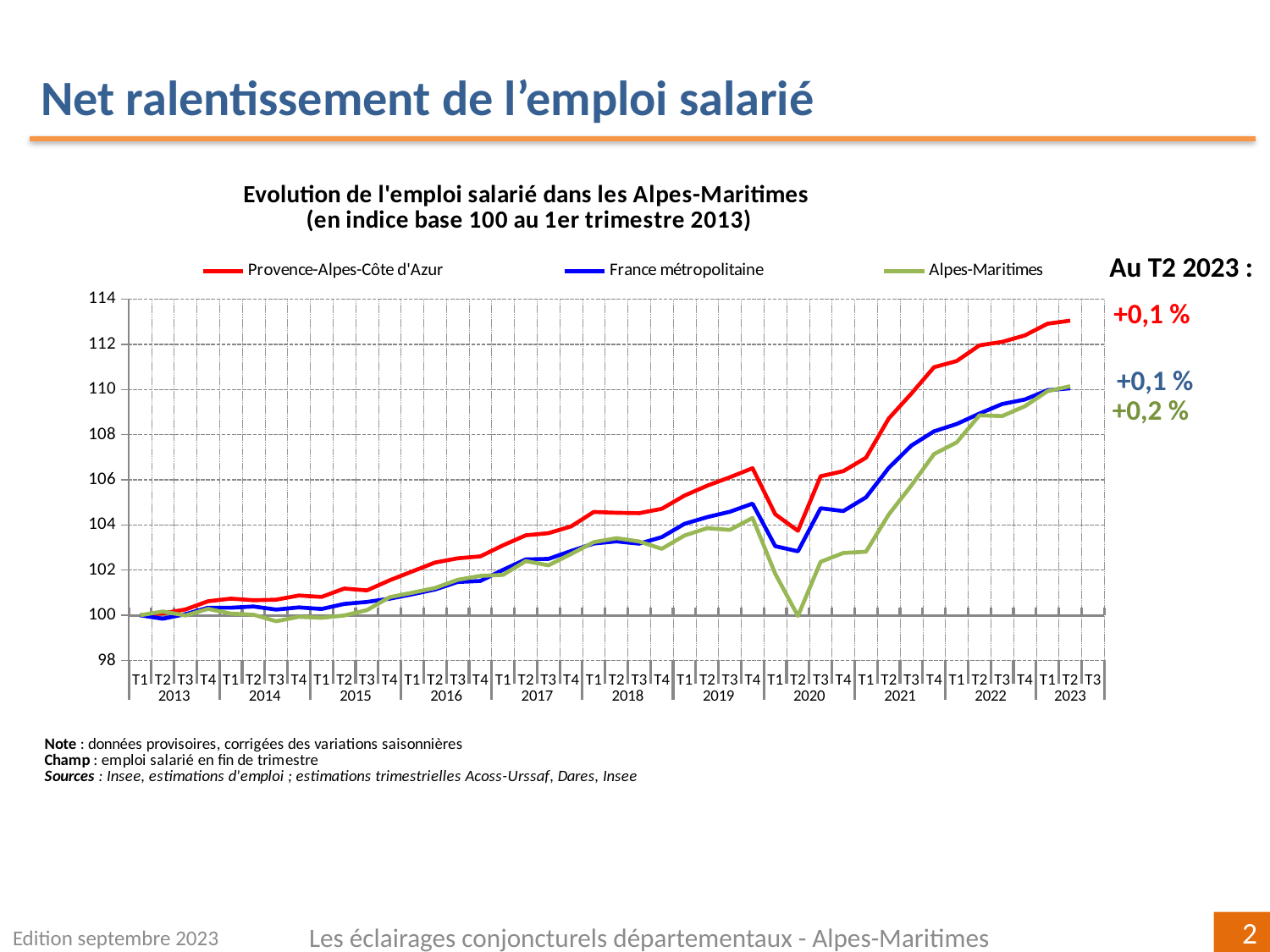
Which series has the lowest value at T2 2020? Alpes-Maritimes What kind of chart is shown on the slide? line chart How many series does the legend list? 3 Is the value for Provence-Alpes-Côte d'Azur at T2 2023 greater or less than 112? greater At T4 2019, which is higher: Provence-Alpes-Côte d'Azur or France métropolitaine? Provence-Alpes-Côte d'Azur Is the value for Alpes-Maritimes at T2 2020 greater or less than 102? less Which series has the highest value at T2 2023? Provence-Alpes-Côte d'Azur What quarterly change is shown for Alpes-Maritimes at T2 2023? +0,2 % Overall, do the series rise or fall from 2013 to 2023? rise Is the value for France métropolitaine at T2 2023 greater or less than 108? greater What is the title of the chart? Evolution de l'emploi salarié dans les Alpes-Maritimes (en indice base 100 au 1er trimestre 2013) Which series is plotted in red? Provence-Alpes-Côte d'Azur